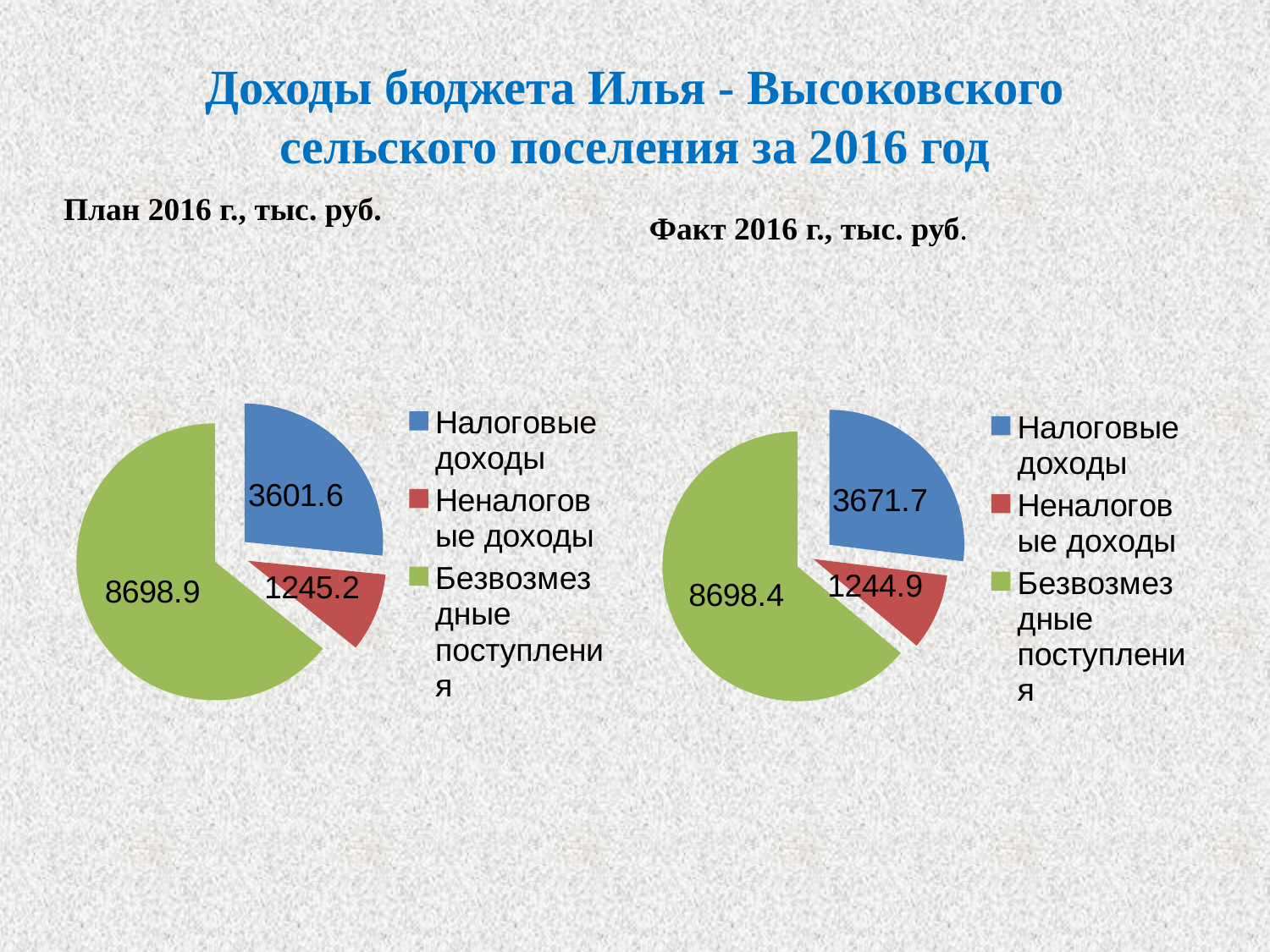
Is the value for Налоговые доходы larger in the left chart (План) or the right chart (Факт)? Right chart (Факт) In the right pie chart (Факт 2016 г., тыс. руб.), what is the value for Неналоговые доходы? 1244.9 In the right pie chart (Факт 2016 г., тыс. руб.), what is the value for Безвозмездные поступления? 8698.4 In the left pie chart (План 2016 г., тыс. руб.), which colour represents Безвозмездные поступления? Green In the left pie chart (План 2016 г., тыс. руб.), what is the value for Налоговые доходы? 3601.6 In the left pie chart (План 2016 г., тыс. руб.), what is the difference between Налоговые доходы and Неналоговые доходы? 2356.4 In the right pie chart (Факт 2016 г., тыс. руб.), what is the difference between Безвозмездные поступления and Налоговые доходы? 5026.7 How many categories does the left pie chart (План 2016 г., тыс. руб.) show? 3 In the right pie chart (Факт 2016 г., тыс. руб.), which category has the smallest value? Неналоговые доходы In the left pie chart (План 2016 г., тыс. руб.), what is the total of all three categories? 13545.7 In the left pie chart (План 2016 г., тыс. руб.), which category has the largest value? Безвозмездные поступления What type of chart is used for Факт 2016 г., тыс. руб.? Pie chart